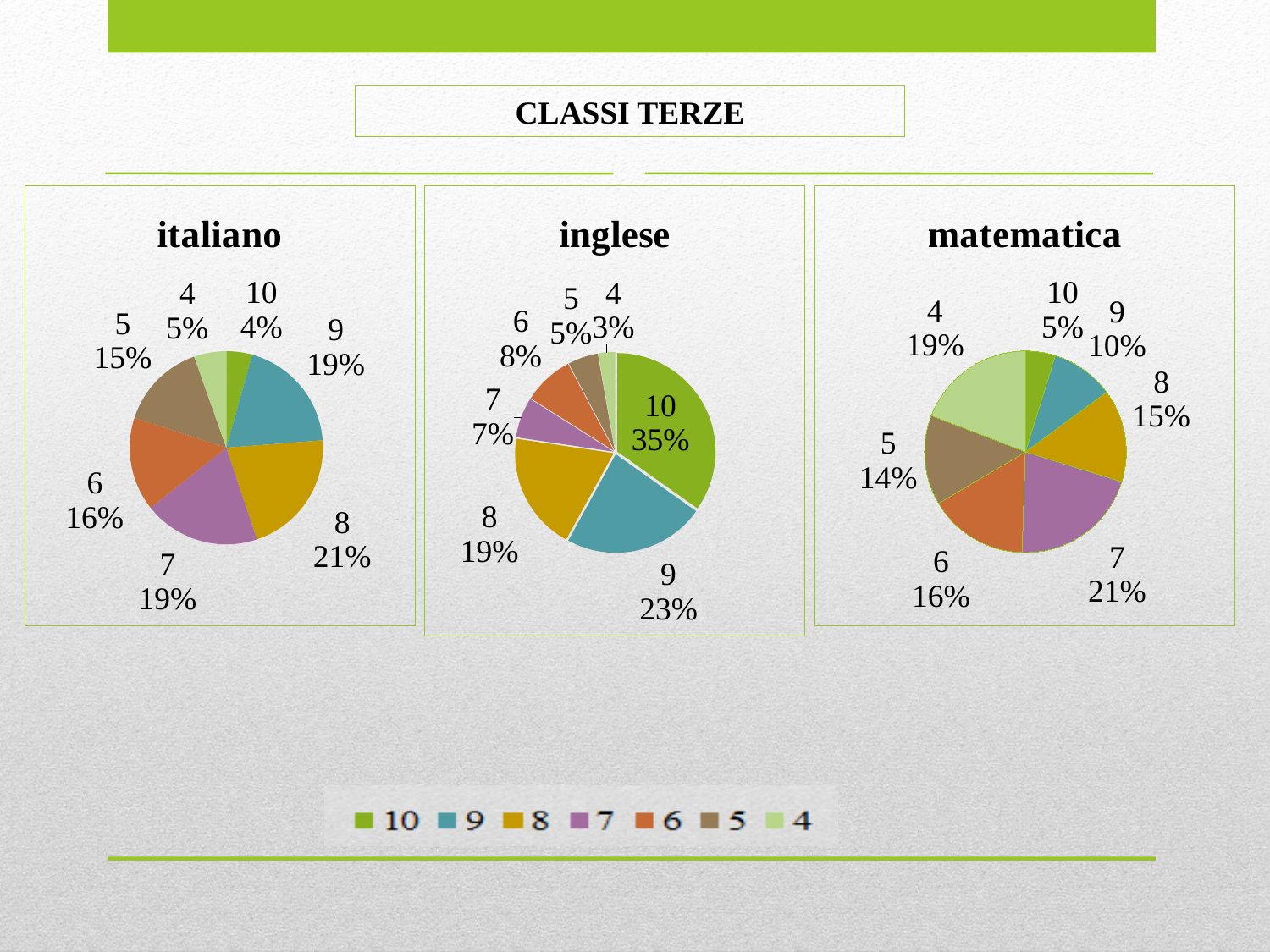
In the 'matematica' pie chart, which grade has the largest share? 7 What type of chart is used for 'inglese'? pie chart In the 'inglese' pie chart, which grade has the largest share? 10 In the 'inglese' pie chart, what share does grade 10 have? 35% How many entries does the legend at the bottom of the slide list? 7 In the 'matematica' pie chart, which is larger: the share of grade 8 or the share of grade 5? 8 In the 'inglese' pie chart, which grade has the smallest share? 4 In the 'inglese' pie chart, what is the difference between the shares of grade 10 and grade 9? 12% In the 'italiano' pie chart, what share does grade 8 have? 21% In the 'italiano' pie chart, which grade has the smallest share? 10 How many slices does the 'italiano' pie chart have? 7 In the 'matematica' pie chart, what share does grade 4 have? 19%